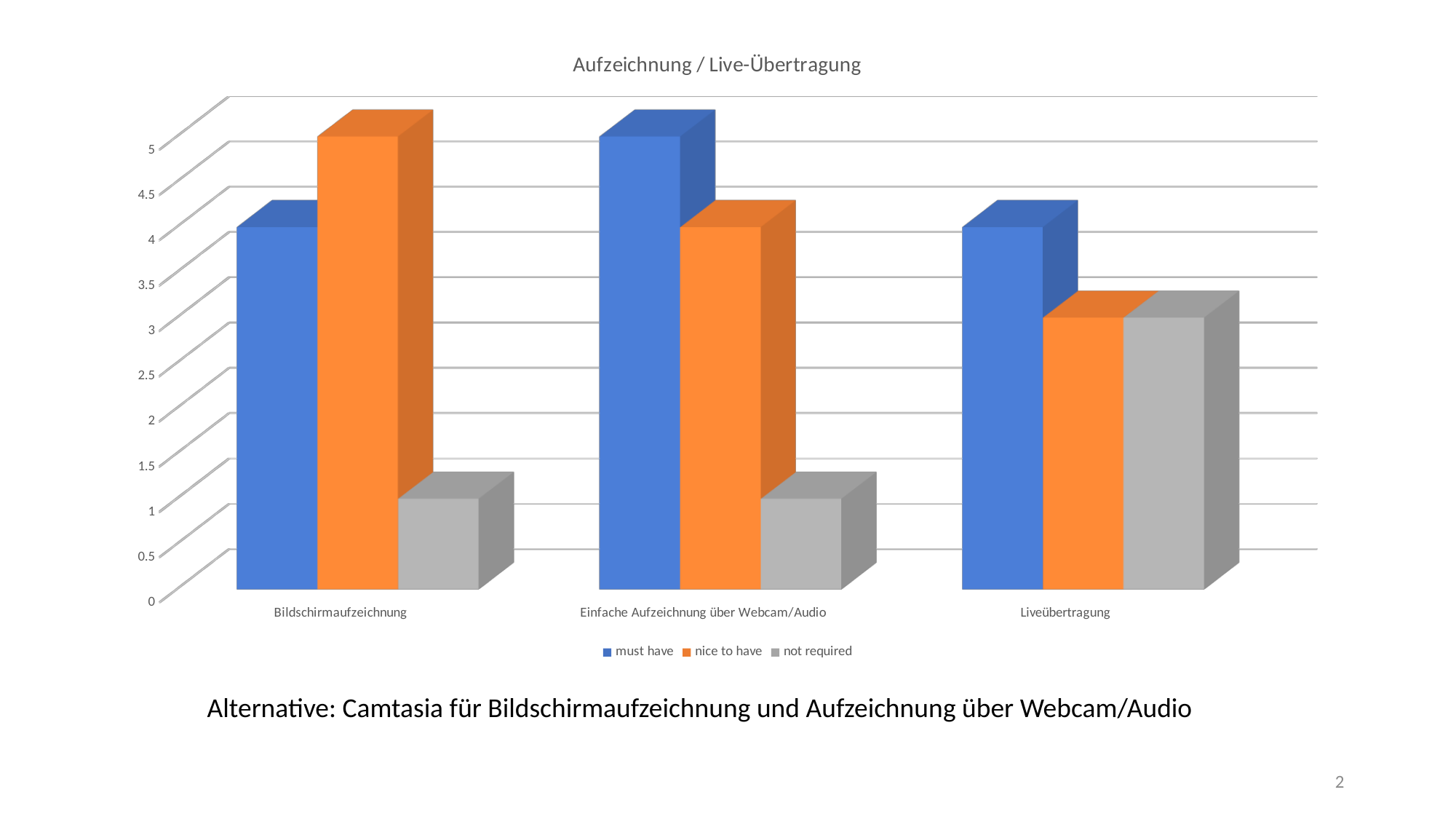
How many series does the legend list? 3 Which category has the lowest 'nice to have' value? Liveübertragung What is the title of the chart? Aufzeichnung / Live-Übertragung What is the 'not required' value for Liveübertragung? 3 What is the 'nice to have' value for Bildschirmaufzeichnung? 5 For Bildschirmaufzeichnung, which is larger: 'must have' or 'nice to have'? nice to have How many categories are shown on the x axis? 3 What is the 'must have' value for Einfache Aufzeichnung über Webcam/Audio? 5 What kind of chart is shown on the slide? bar chart Which category has the highest 'must have' value? Einfache Aufzeichnung über Webcam/Audio Which legend entry is shown in orange? nice to have Is the 'not required' value for Bildschirmaufzeichnung greater or less than 2? less